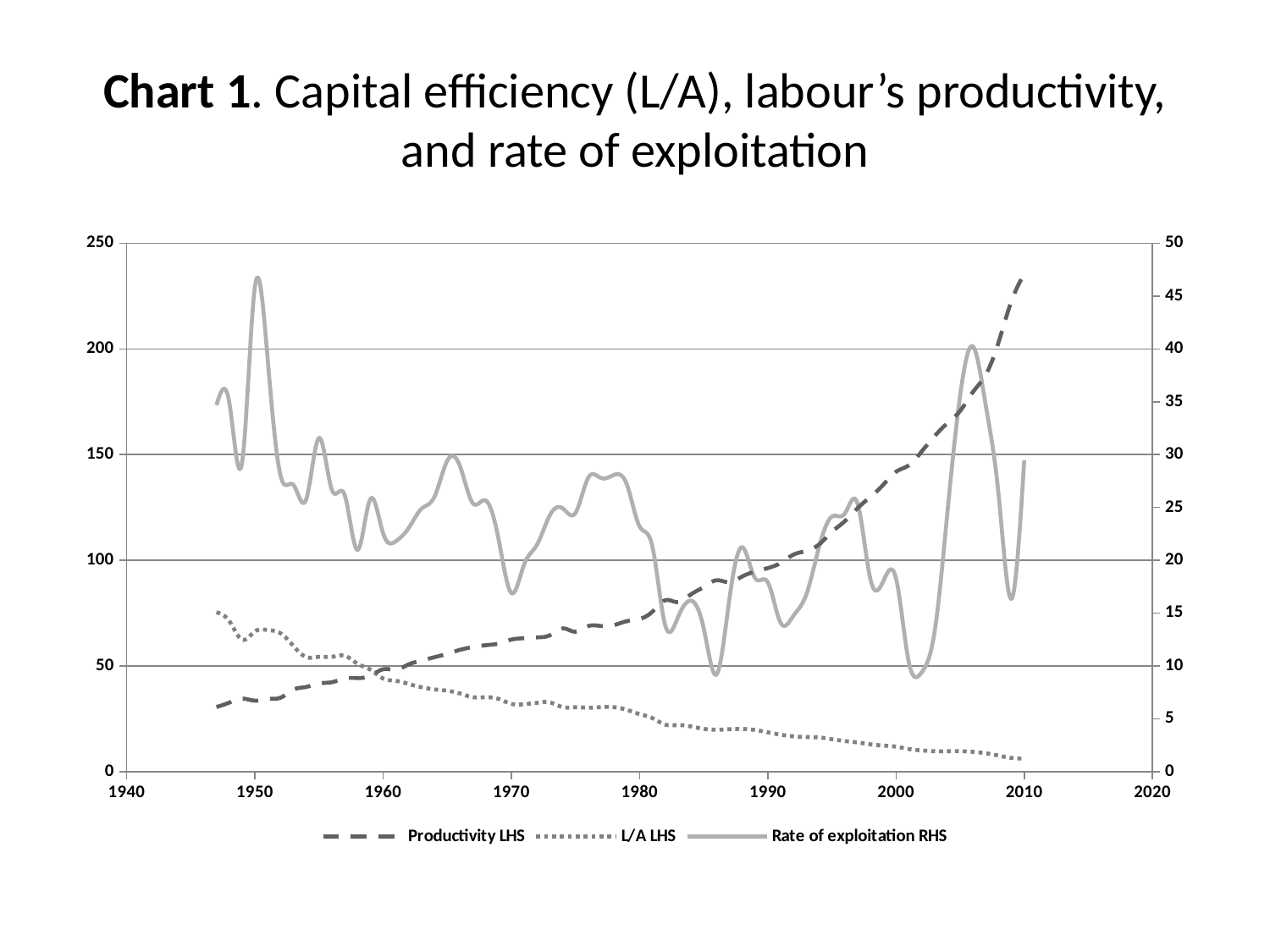
What kind of chart is shown on the slide? line chart Is the value for Productivity LHS in 1950 greater or less than 50? less Is the value for L/A LHS in 2010 greater or less than 50? less How many series does the legend list? 3 Is the value for Rate of exploitation RHS at its peak around 1950 greater or less than 40 on the right-hand axis? greater Does the L/A LHS series generally rise or fall from 1947 to 2010? fall In 2010, which is larger: Productivity LHS or L/A LHS? Productivity LHS Which series are listed in the legend? Productivity LHS, L/A LHS, Rate of exploitation RHS Does the Productivity LHS series generally rise or fall from 1947 to 2010? rise In 1950, which is larger: Productivity LHS or L/A LHS? L/A LHS